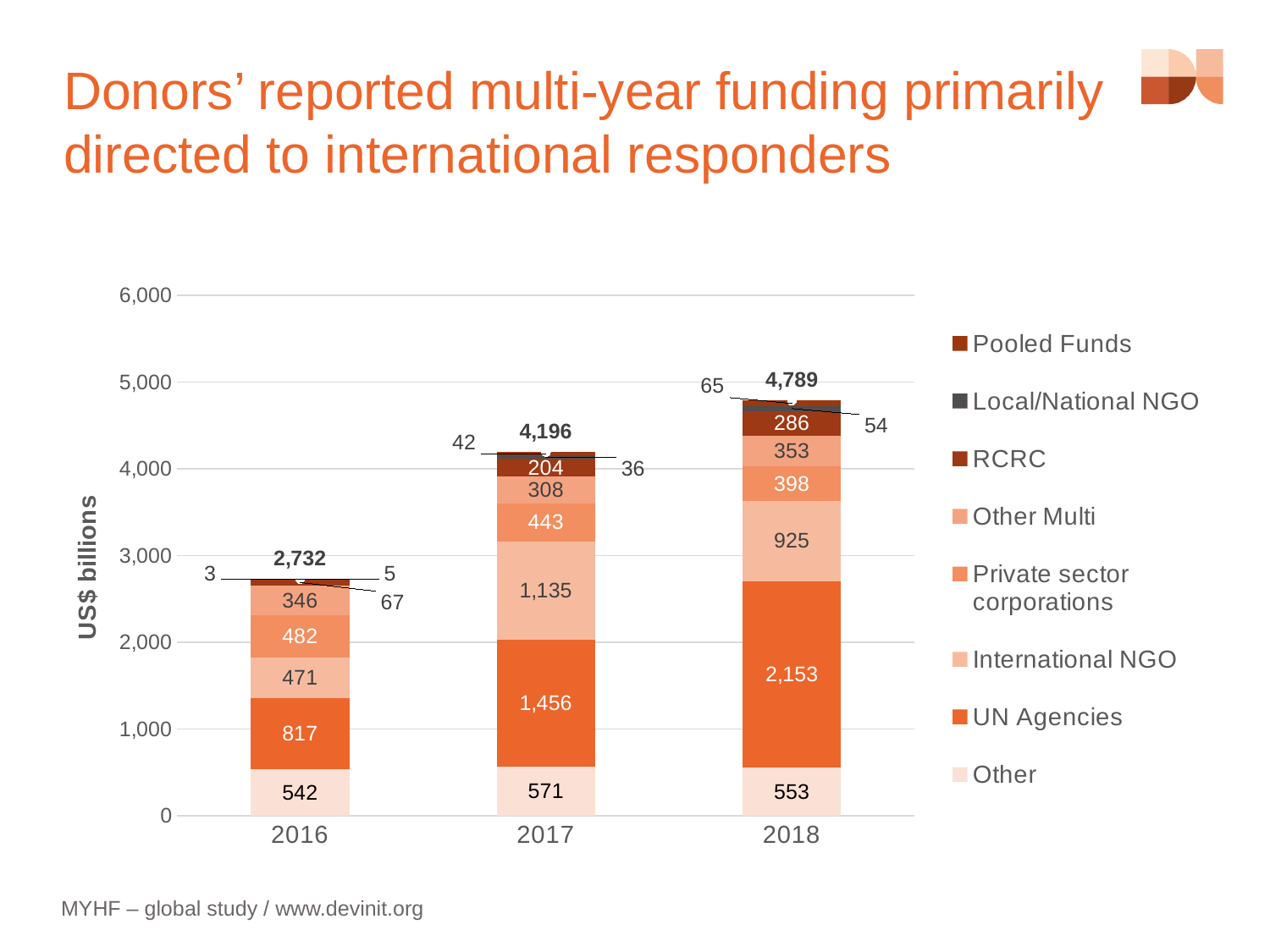
Do the total values rise or fall from 2016 to 2018? Rise Which year has the highest total multi-year funding? 2018 What is the value for UN Agencies in 2018? 2,153 What is the label on the y axis? US$ billions How many years are shown on the x axis? 3 Which year has the larger value for International NGO, 2017 or 2018? 2017 How many series does the legend list? 8 What kind of chart is shown on the slide? Stacked bar chart What is the total of the stacked bar for 2017? 4,196 Which year has the lowest total multi-year funding? 2016 What is the value for RCRC in 2018? 286 What is the difference between the 2018 total (4,789) and the 2016 total (2,732)? 2,057